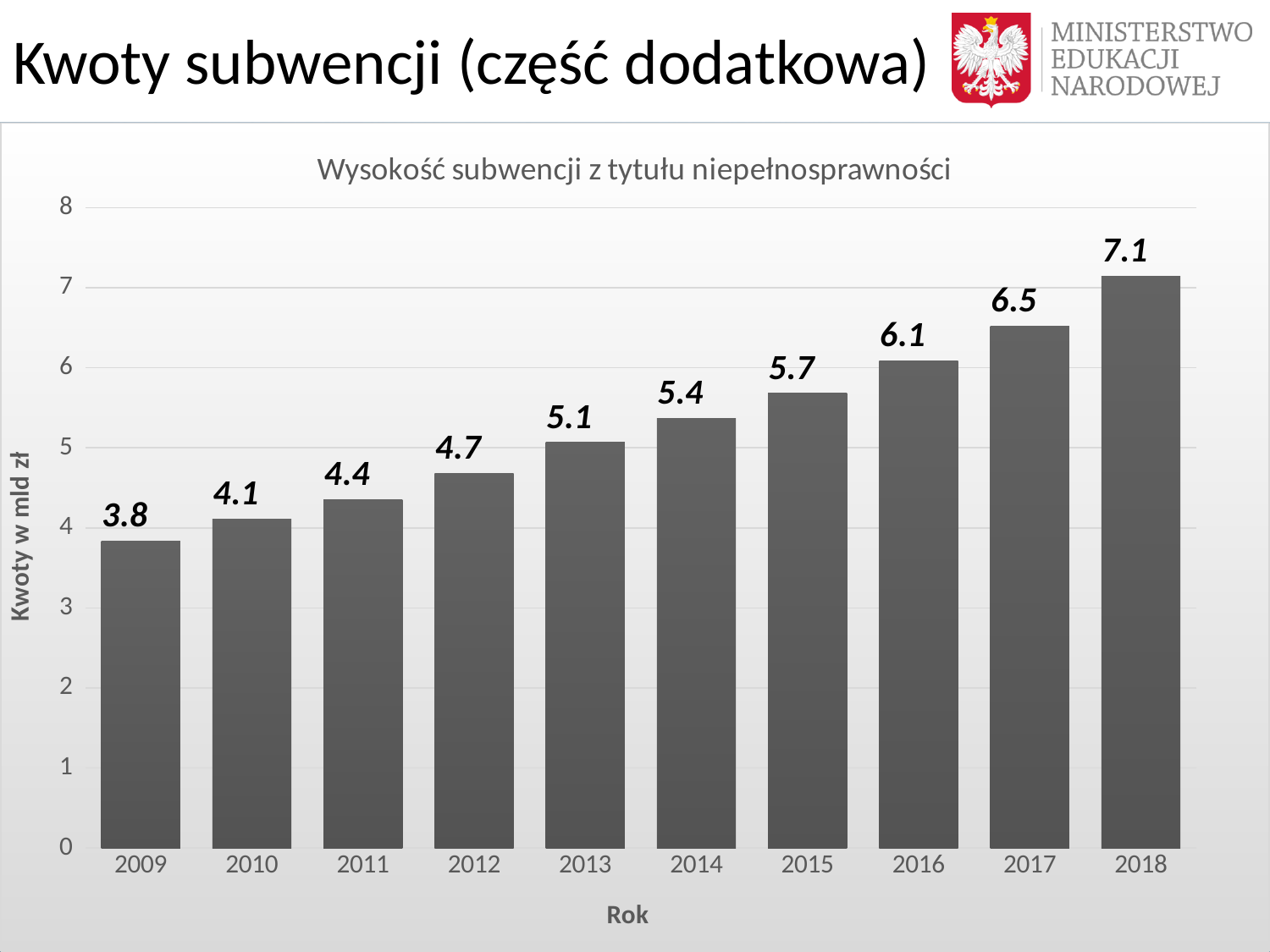
Which year has the highest value? 2018 Which is larger, the value for 2012 or the value for 2015? 2015 What is the value for 2018? 7.1 Is the value for 2017 greater or less than 6? greater What is the value for 2014? 5.4 What is the difference between the values for 2018 and 2009? 3.3 Do the values rise or fall from 2009 to 2018? rise Which year has the lowest value? 2009 What is the difference between the values for 2016 and 2013? 1.0 How many years are shown on the x axis? 10 What kind of chart is this? bar chart What is the value for 2009? 3.8